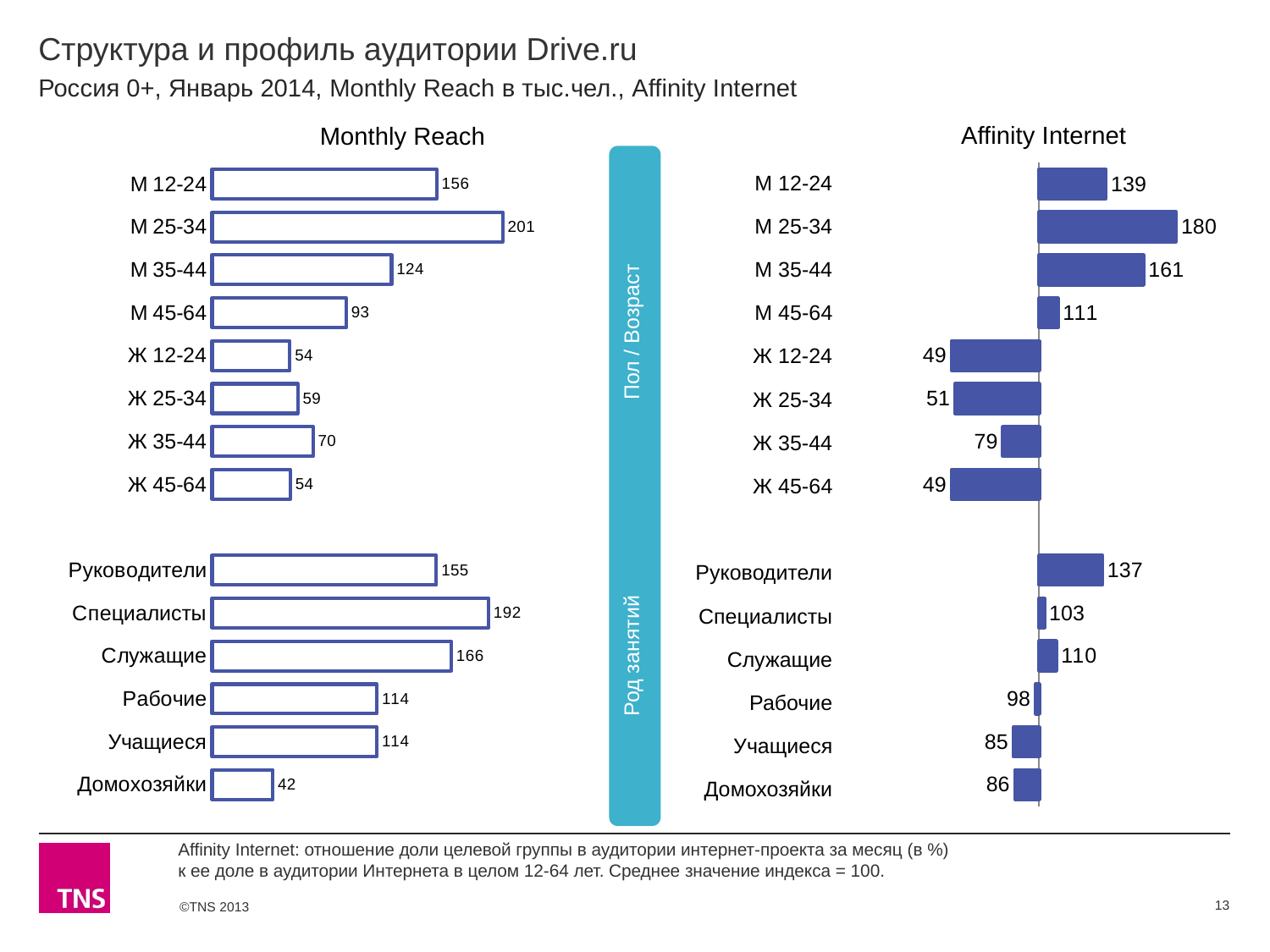
In the Affinity Internet chart, which is larger: М 35-44 or М 12-24? М 35-44 In the Monthly Reach chart, what is the value for Ж 45-64? 54 In the Affinity Internet chart, what is the difference between М 25-34 and М 45-64? 69 In the Affinity Internet chart, what is the value for Ж 35-44? 79 In the Monthly Reach chart, which category has the lowest value? Домохозяйки What type of chart is the Affinity Internet chart? Bar chart In the Monthly Reach chart, how many categories are plotted? 14 In the Monthly Reach chart, what is the value for М 25-34? 201 What is the title of the chart on the left side of the slide? Monthly Reach In the Affinity Internet chart, which category has the highest value? М 25-34 In the Monthly Reach chart, what is the difference between Специалисты and Руководители? 37 In the Affinity Internet chart, what is the value for Рабочие? 98